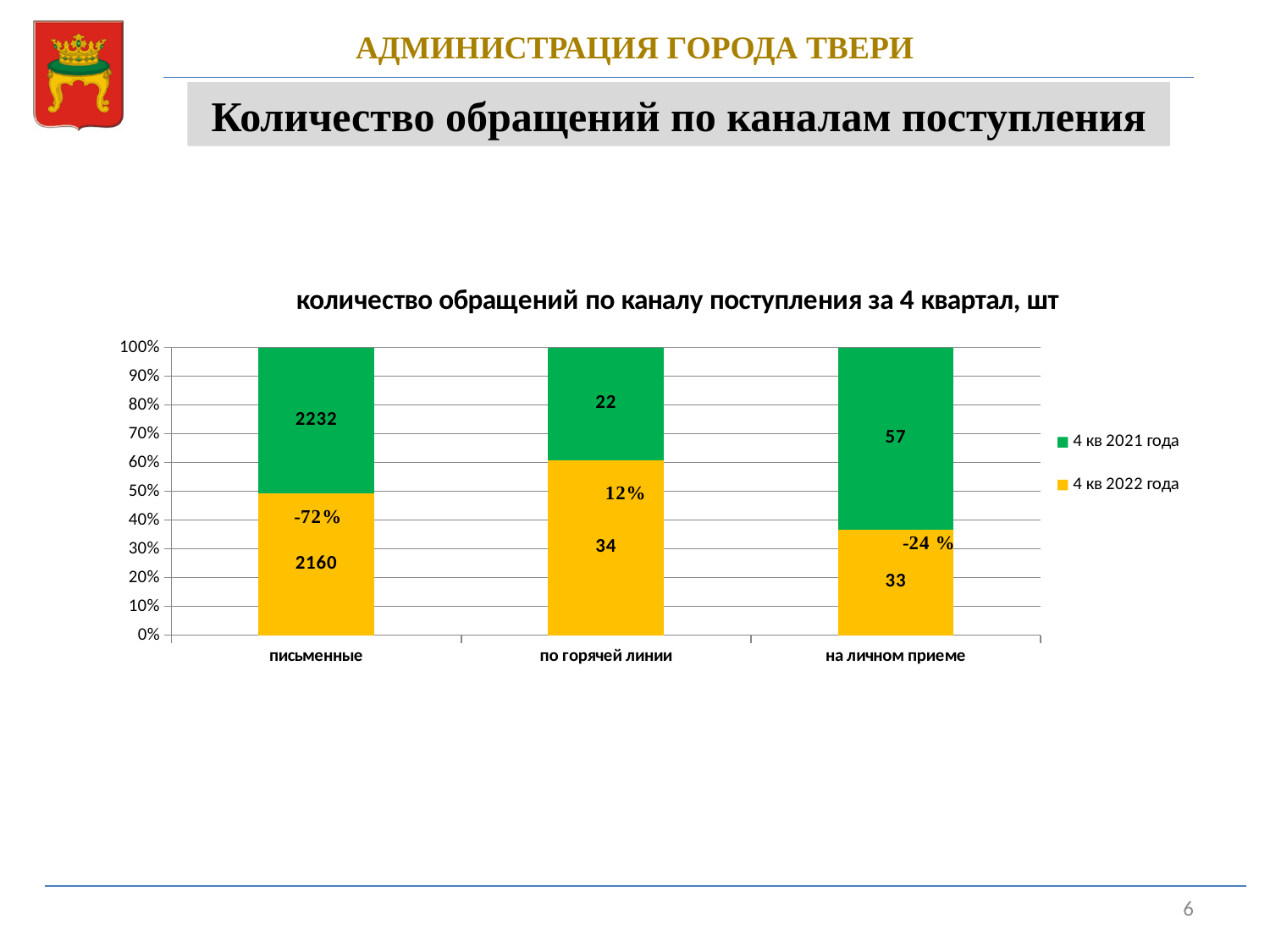
How many categories are shown on the x axis? 3 For по горячей линии, which series has the larger value: 4 кв 2021 года or 4 кв 2022 года? 4 кв 2022 года What is the total of the two values labelled on the на личном приеме bar? 90 What is the value for по горячей линии in the 4 кв 2021 года series? 22 What is the difference between the 4 кв 2021 года and 4 кв 2022 года values for письменные? 72 What is the value for письменные in the 4 кв 2021 года series? 2232 What is the value for письменные in the 4 кв 2022 года series? 2160 Which category has the lowest value in the 4 кв 2022 года series? на личном приеме What is the value for на личном приеме in the 4 кв 2022 года series? 33 What kind of chart is shown on the slide? stacked bar chart Which category has the highest value in the 4 кв 2021 года series? письменные How many series does the legend list? 2